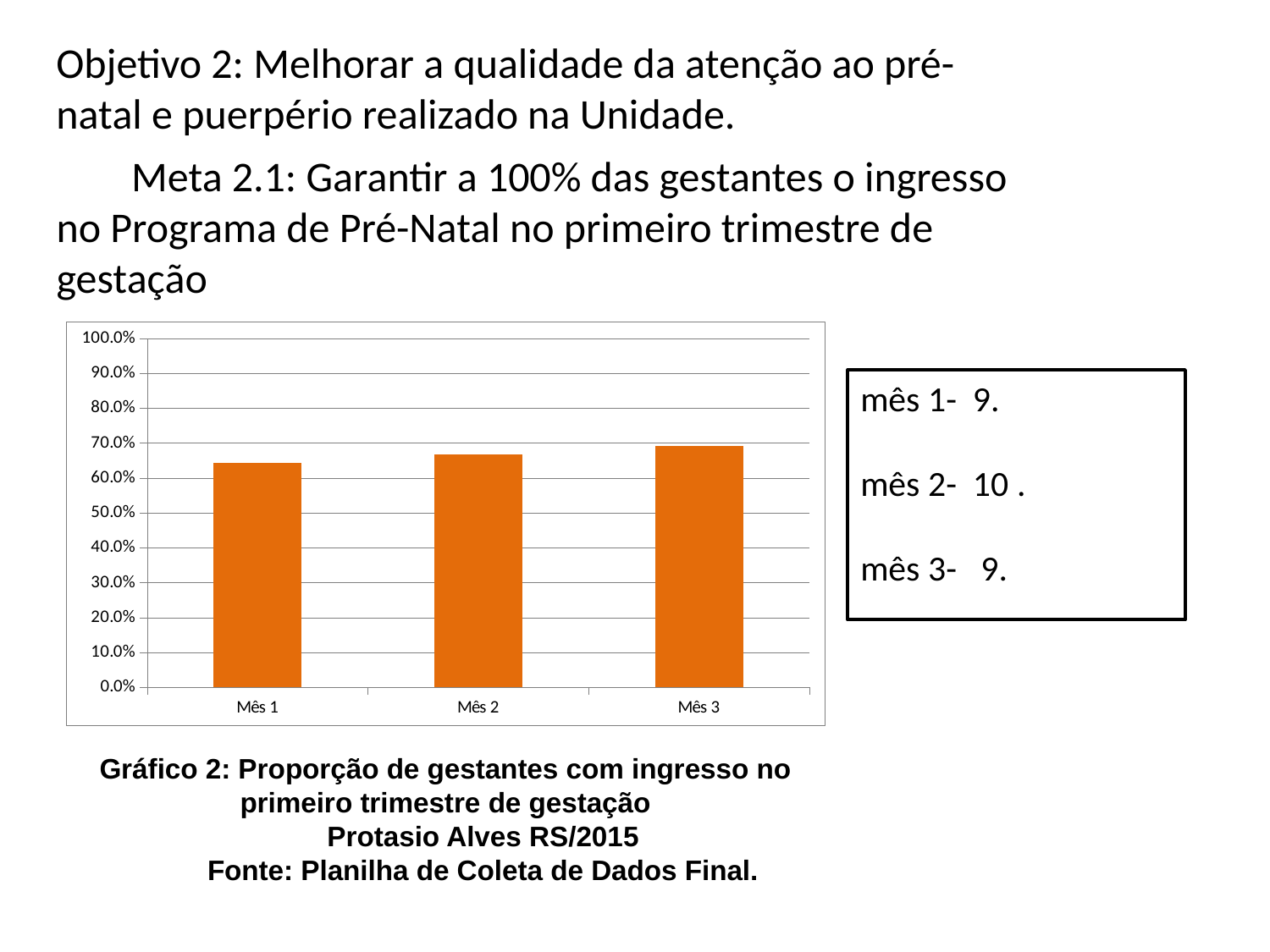
What kind of chart is shown on the slide? bar chart How many categories (months) are plotted on the chart? 3 Is the value for Mês 2 greater or less than 70.0%? less Which month has the lowest bar on the chart? Mês 1 Which is larger, the value for Mês 1 or the value for Mês 3? Mês 3 Is the value for Mês 1 greater or less than 70.0%? less What is the highest value shown on the vertical axis of the chart? 100.0% Is the value for Mês 1 greater or less than 60.0%? greater What colour are the bars in the chart? orange Which month has the highest bar on the chart? Mês 3 Do the values rise or fall from Mês 1 to Mês 3? rise